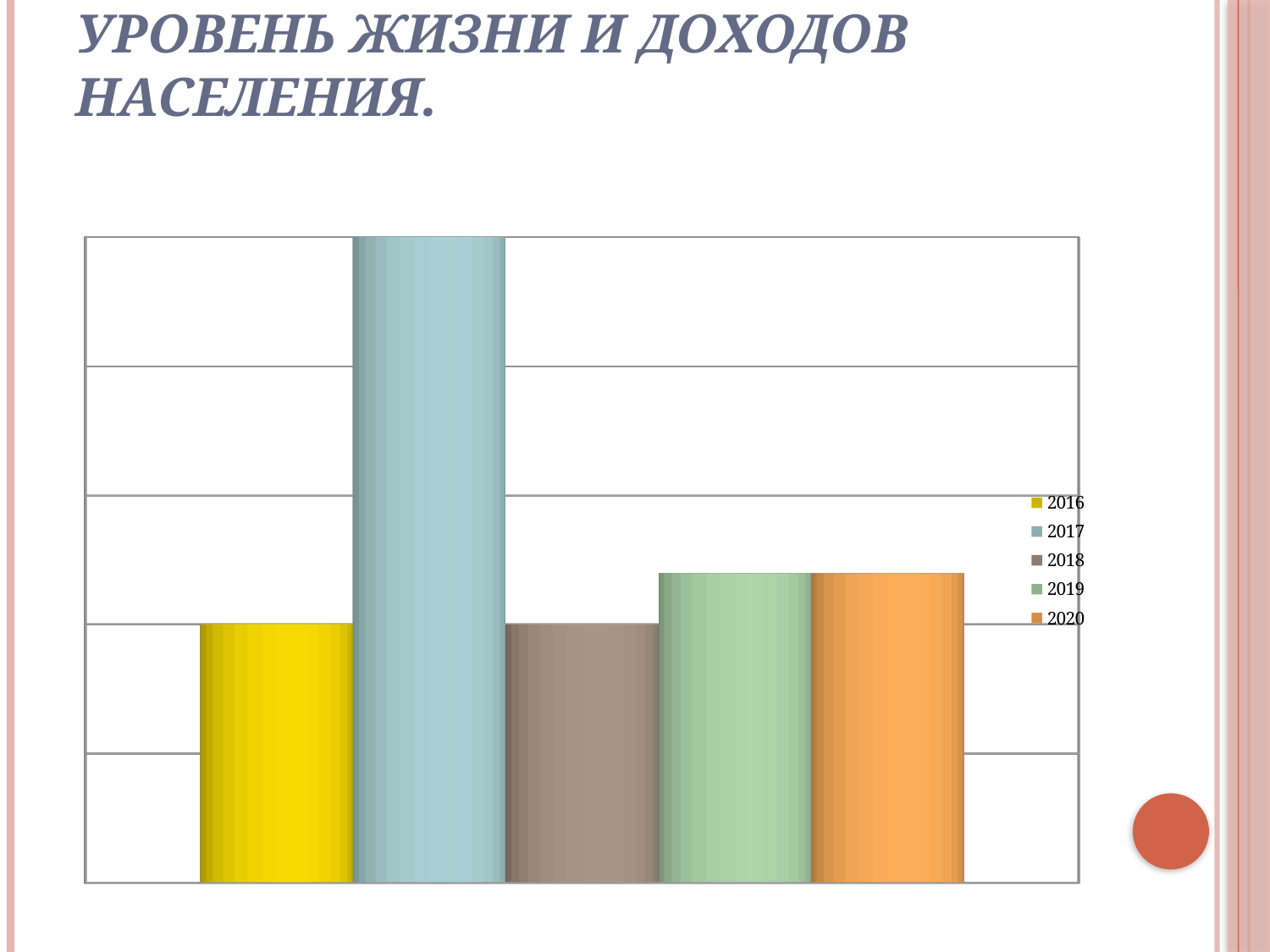
What is the last entry listed in the chart legend? 2020 Which is larger, the bar for 2017 or the bar for 2016? 2017 Which is larger, the bar for 2018 or the bar for 2017? 2017 Which is larger, the bar for 2019 or the bar for 2018? 2019 What is the first entry listed in the chart legend? 2016 What kind of chart is shown on the slide? bar chart How many series does the legend list? 5 How many bars are plotted in the chart? 5 Which year has the highest bar in the chart? 2017